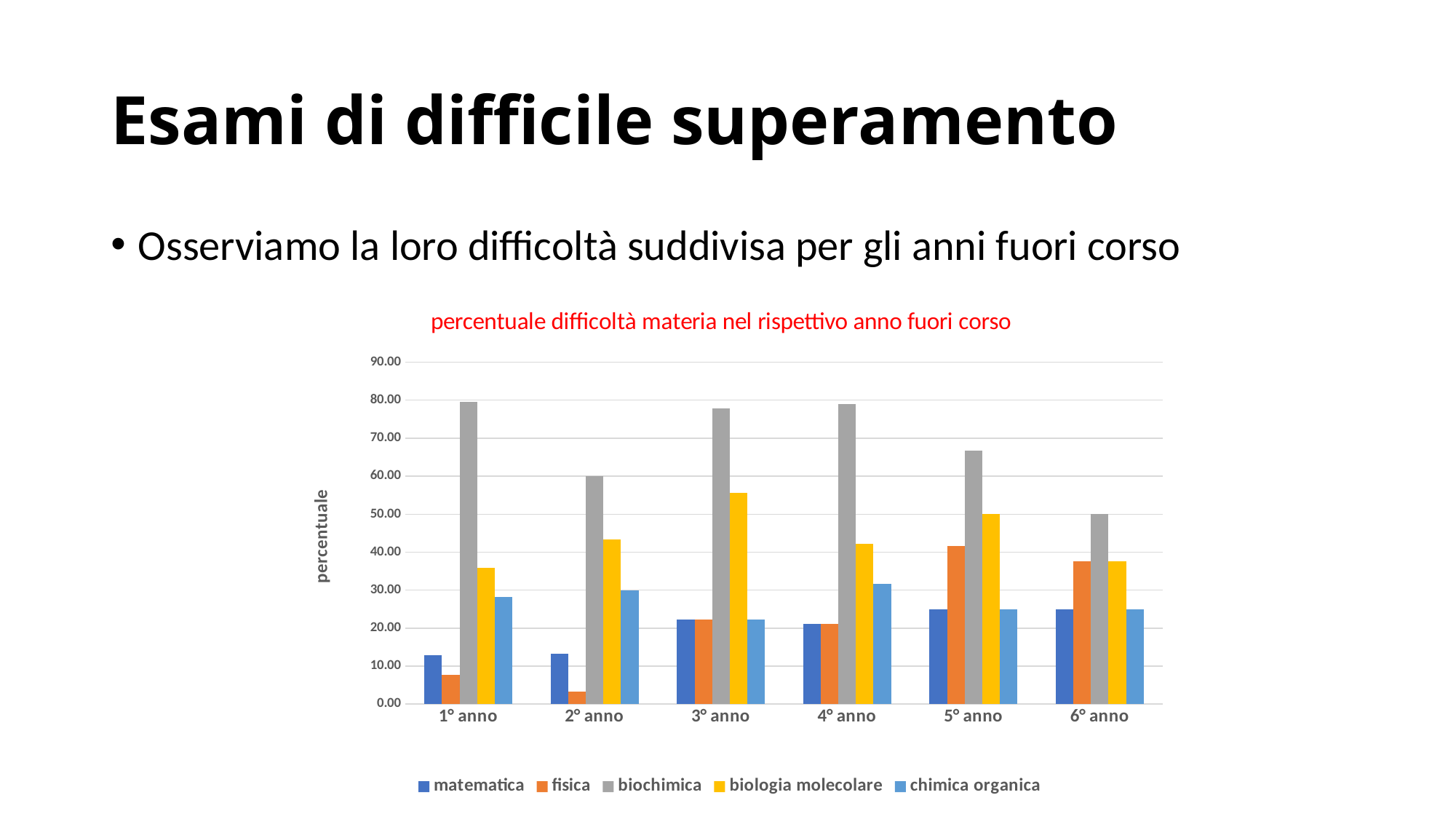
Which subject has the lowest value in 2° anno? fisica Which subject has the highest value in 1° anno? biochimica Is the value for biologia molecolare in 3° anno greater or less than 50.00? greater Is the value for fisica in 2° anno greater or less than 10.00? less In 3° anno, which is larger: biologia molecolare or chimica organica? biologia molecolare In which year is the value for biochimica lowest? 6° anno What kind of chart is shown on the slide? bar chart Which is larger: fisica in 5° anno or fisica in 6° anno? fisica in 5° anno How many series does the legend list? 5 Is the value for biochimica in 1° anno greater or less than 70.00? greater How many year categories are shown on the x axis? 6 What is the title of the chart? percentuale difficoltà materia nel rispettivo anno fuori corso